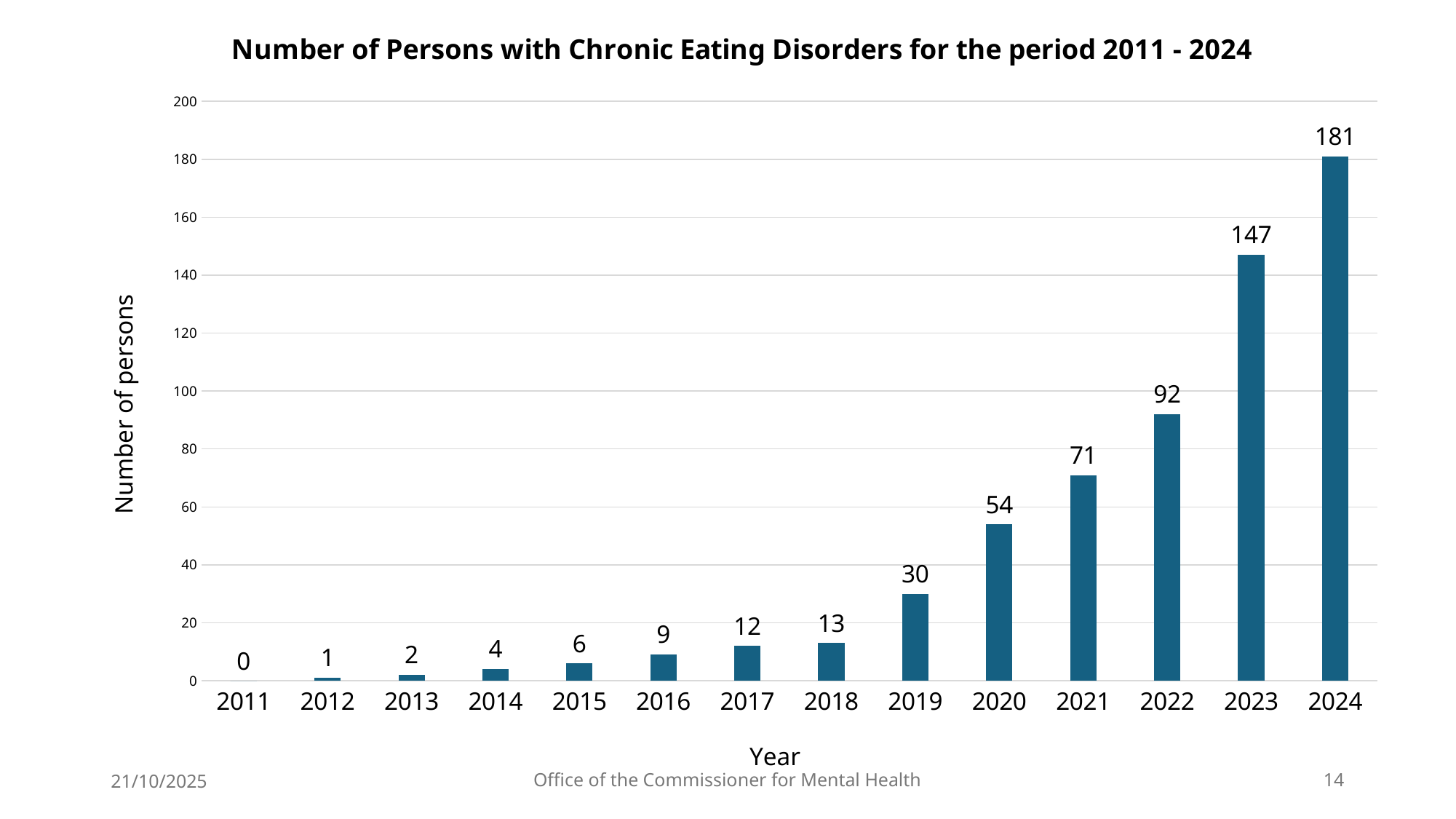
What is the number of persons with chronic eating disorders in 2016? 9 What kind of chart is shown on the slide? Bar chart What is the difference between the number of persons in 2022 and in 2021? 21 Which year has more persons with chronic eating disorders, 2019 or 2021? 2021 Which year has the lowest number of persons with chronic eating disorders? 2011 Do the values rise or fall from 2011 to 2024? Rise What is the difference between the number of persons in 2024 and in 2023? 34 What is the number of persons with chronic eating disorders in 2020? 54 Which year has the highest number of persons with chronic eating disorders? 2024 How many years are shown on the x axis of the chart? 14 Is the value for 2023 greater or less than 140? greater What is the number of persons with chronic eating disorders in 2024? 181